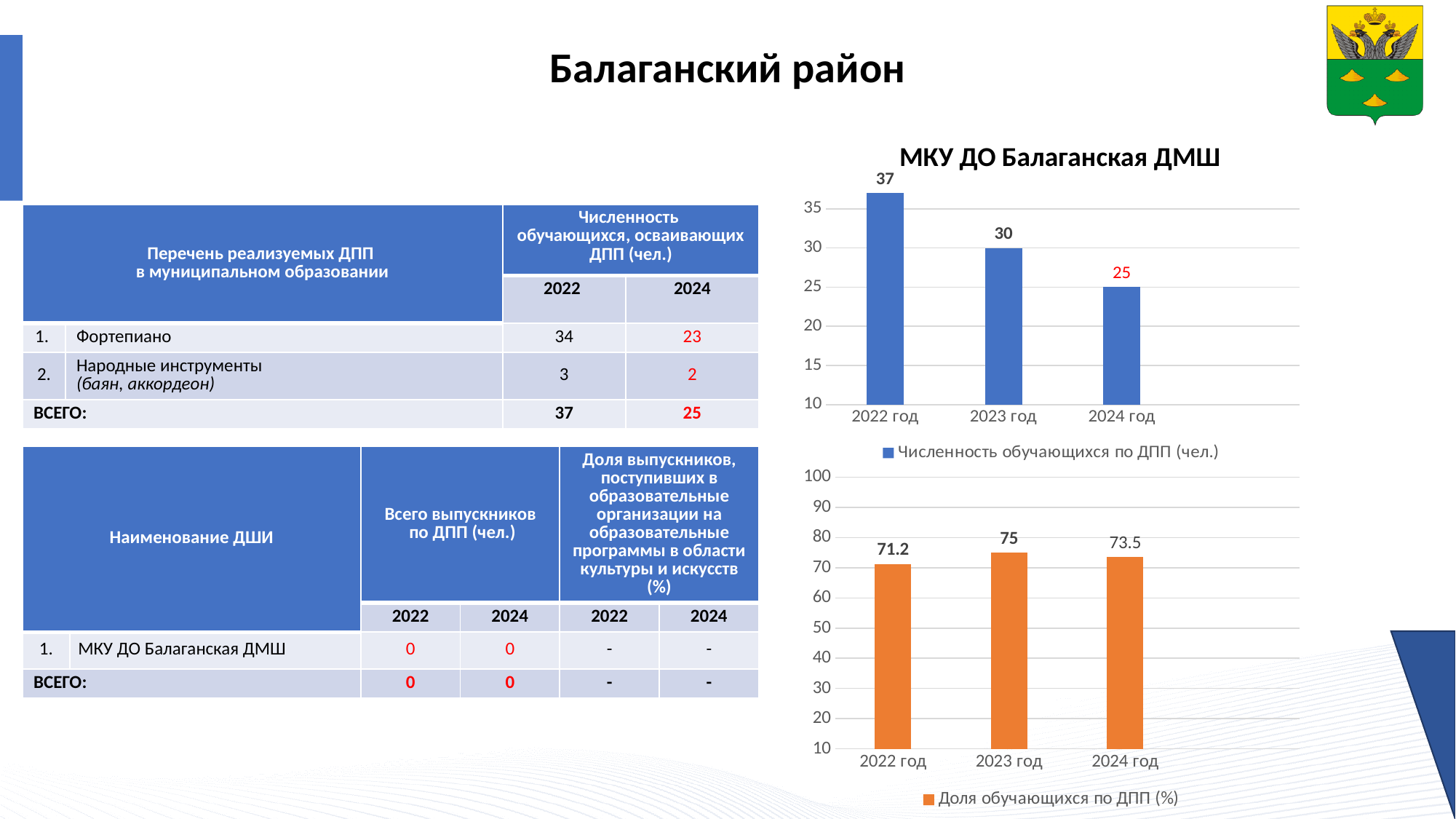
In the top chart titled 'МКУ ДО Балаганская ДМШ', what is the value for 2022 год? 37 What type of chart is the lower chart with orange bars? bar chart In the lower chart with orange bars, how many bars are plotted? 3 In the top chart titled 'МКУ ДО Балаганская ДМШ', what is the value for 2024 год? 25 In the lower chart with orange bars, what is the value for 2022 год? 71.2 In the lower chart with orange bars, which year has the highest value? 2023 год In the top chart titled 'МКУ ДО Балаганская ДМШ', what is the difference between the values for 2022 год and 2024 год? 12 In the lower chart with orange bars, what is the value for 2023 год? 75 In the top chart titled 'МКУ ДО Балаганская ДМШ', what series name does the legend show? Численность обучающихся по ДПП (чел.) In the top chart titled 'МКУ ДО Балаганская ДМШ', do the values rise or fall from 2022 год to 2024 год? fall In the top chart titled 'МКУ ДО Балаганская ДМШ', which year has the lowest value? 2024 год In the top chart titled 'МКУ ДО Балаганская ДМШ', which year has the highest value? 2022 год